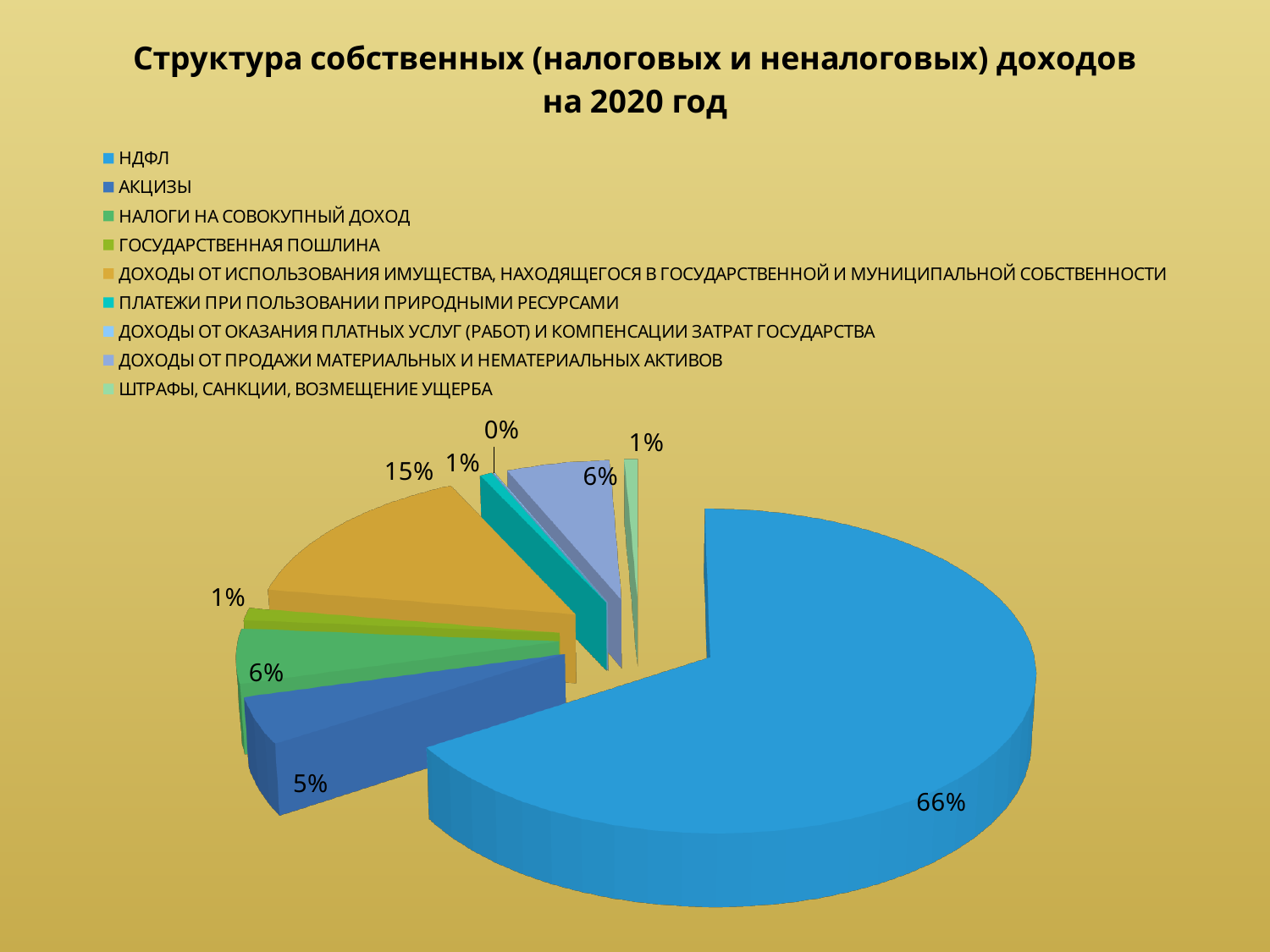
How many categories does the legend list? 9 Which category has the smallest slice of the pie? ДОХОДЫ ОТ ОКАЗАНИЯ ПЛАТНЫХ УСЛУГ (РАБОТ) И КОМПЕНСАЦИИ ЗАТРАТ ГОСУДАРСТВА What share of the pie does АКЦИЗЫ have? 5% What share of the pie does ДОХОДЫ ОТ ОКАЗАНИЯ ПЛАТНЫХ УСЛУГ (РАБОТ) И КОМПЕНСАЦИИ ЗАТРАТ ГОСУДАРСТВА have? 0% What kind of chart is shown on the slide? pie chart Which is larger, the АКЦИЗЫ slice or the НАЛОГИ НА СОВОКУПНЫЙ ДОХОД slice? НАЛОГИ НА СОВОКУПНЫЙ ДОХОД Which category has the largest slice of the pie? НДФЛ What share of the pie does ДОХОДЫ ОТ ИСПОЛЬЗОВАНИЯ ИМУЩЕСТВА, НАХОДЯЩЕГОСЯ В ГОСУДАРСТВЕННОЙ И МУНИЦИПАЛЬНОЙ СОБСТВЕННОСТИ have? 15% What is the title of the chart? Структура собственных (налоговых и неналоговых) доходов на 2020 год What is the difference in percentage points between the НДФЛ slice and the ДОХОДЫ ОТ ИСПОЛЬЗОВАНИЯ ИМУЩЕСТВА slice? 51 What share of the pie does НАЛОГИ НА СОВОКУПНЫЙ ДОХОД have? 6% What share of the pie does НДФЛ have? 66%